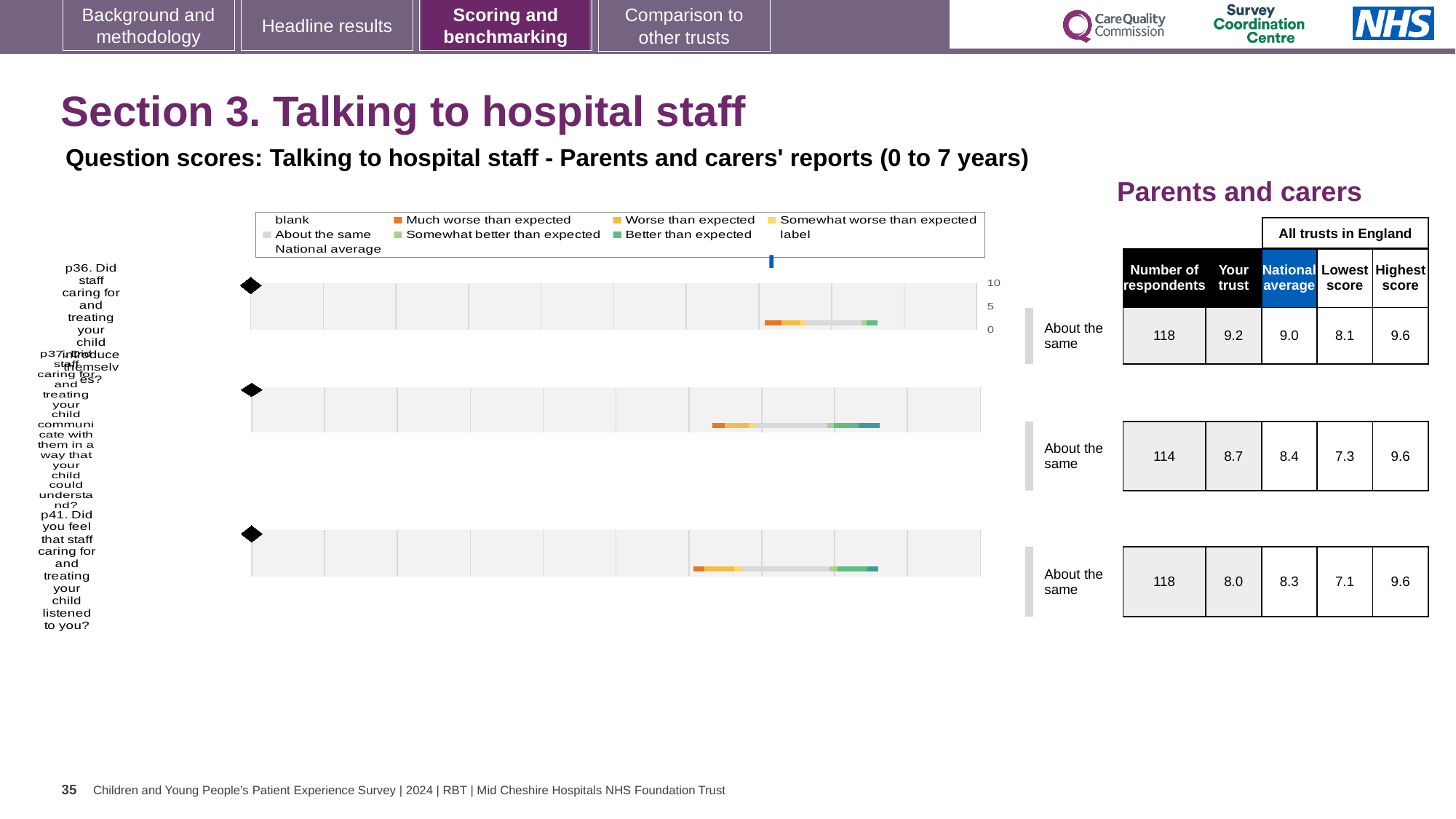
What is the difference between the 'Your trust' score and the national average for the top chart (p36)? 0.2 What kind of chart is used to show the question scores on this slide? bar chart In the chart legend, which entry is shown in grey? About the same What is the 'Your trust' score for the top chart (p36, staff introducing themselves)? 9.2 How many question-score charts are shown on the slide? 3 Which of the three charts has the highest 'Your trust' score? p36 (top chart) For the bottom chart (p41), is the 'Your trust' score or the national average larger? National average What is the national average for the bottom chart (p41, staff listened to you)? 8.3 What is the number of respondents for the middle chart? 114 How many entries does the chart legend list? 9 In the chart legend, which entry is shown in orange? Much worse than expected What is the lowest score across all trusts in England for the middle chart? 7.3